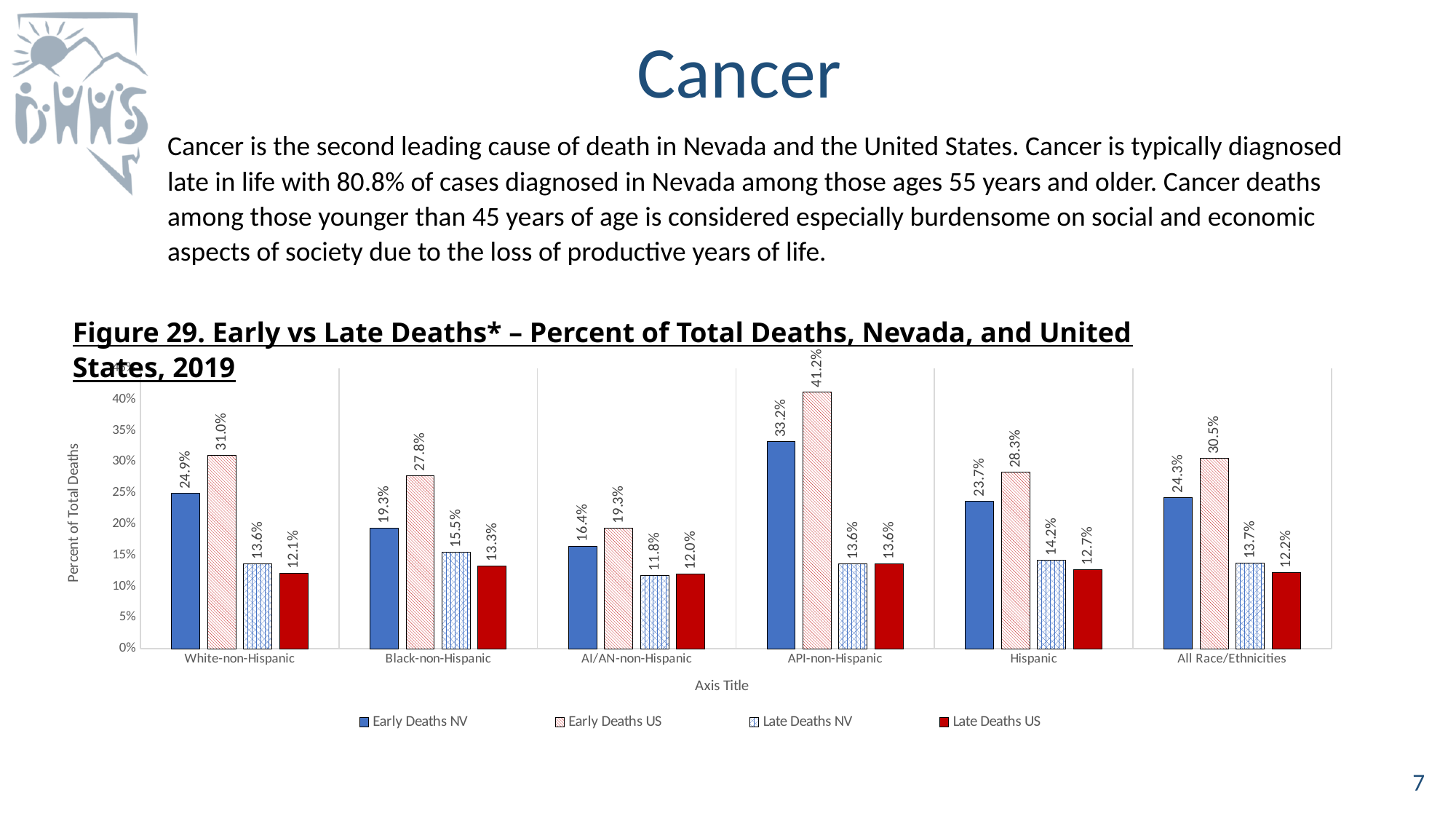
What is the Early Deaths US value for Black-non-Hispanic? 27.8% Which category has the highest Early Deaths US value? API-non-Hispanic How many categories are shown on the x axis? 6 What is the Late Deaths US value for All Race/Ethnicities? 12.2% What kind of chart is shown? Bar chart Which category has the lowest Early Deaths NV value? AI/AN-non-Hispanic How many series does the legend list? 4 Which is larger for Hispanic: Early Deaths NV or Early Deaths US? Early Deaths US What is the Late Deaths NV value for Hispanic? 14.2% What is the difference between the Early Deaths US and Early Deaths NV values for White-non-Hispanic? 6.1% What is the Early Deaths NV value for API-non-Hispanic? 33.2% What is the label on the y axis? Percent of Total Deaths